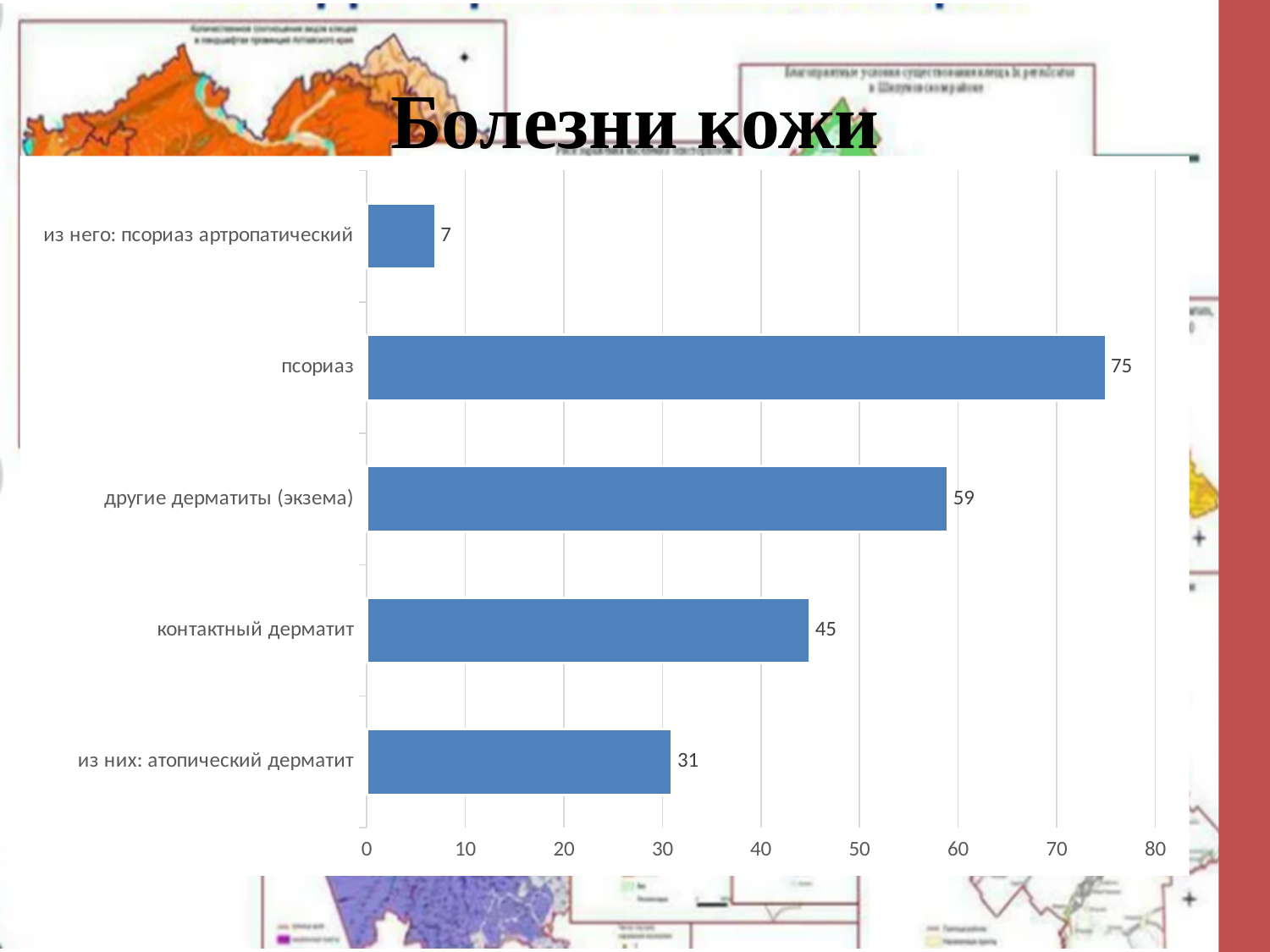
Which category has the lowest value? из него: псориаз артропатический Is the value for другие дерматиты (экзема) greater or less than 50? greater How many categories are shown in the chart? 5 What is the value for контактный дерматит? 45 What kind of chart is shown on the slide? bar chart What is the title of the slide? Болезни кожи What is the value for из них: атопический дерматит? 31 What is the difference between the values for псориаз and другие дерматиты (экзема)? 16 Which is larger, the value for контактный дерматит or the value for из них: атопический дерматит? контактный дерматит What is the value for другие дерматиты (экзема)? 59 Which category has the highest value? псориаз What is the value for псориаз? 75